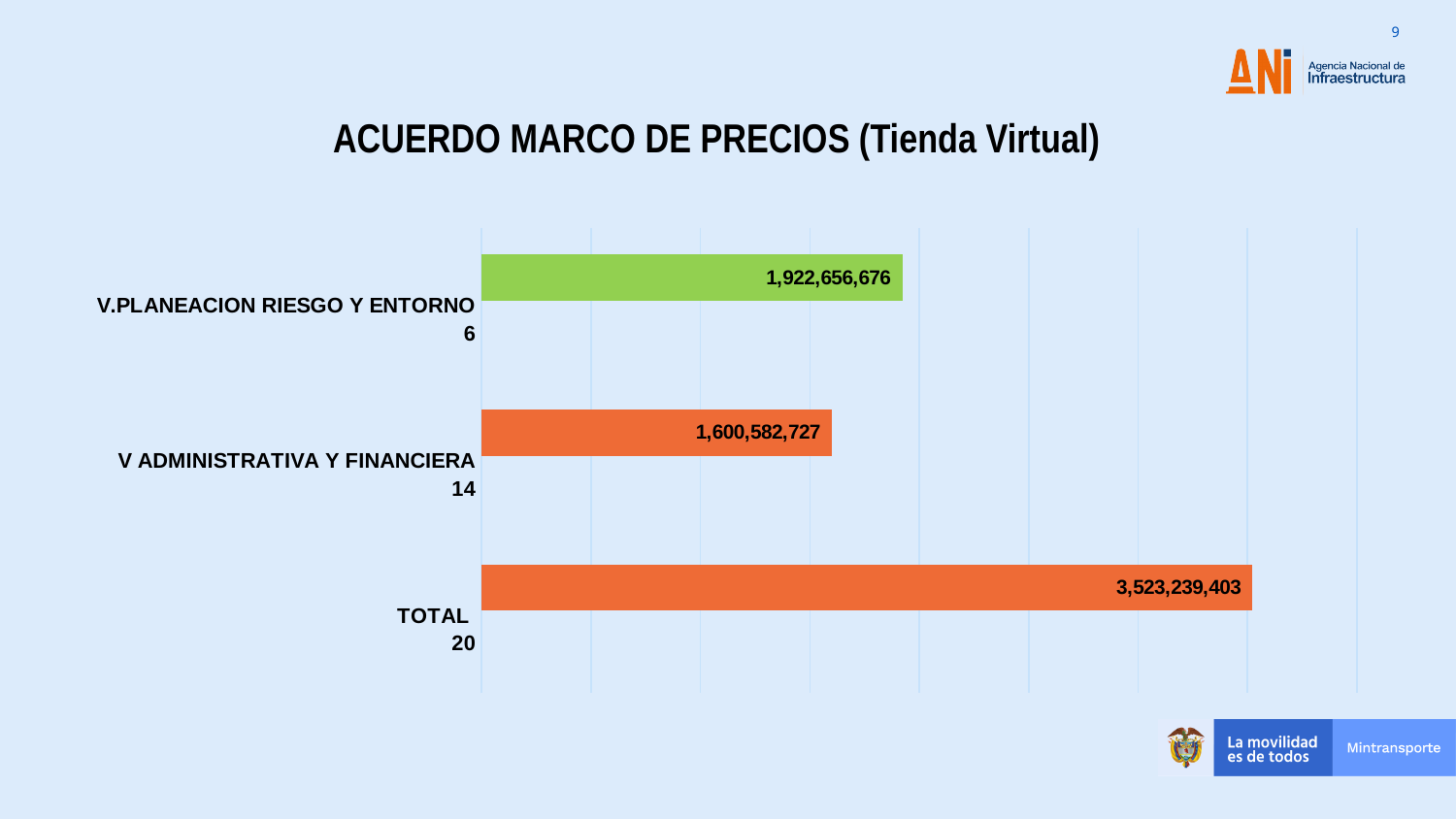
What is the value shown for V.PLANEACION RIESGO Y ENTORNO? 1,922,656,676 Which is larger, the value for V.PLANEACION RIESGO Y ENTORNO or the value for V ADMINISTRATIVA Y FINANCIERA? V.PLANEACION RIESGO Y ENTORNO What type of chart is shown on the slide? Bar chart What is the title of the slide? ACUERDO MARCO DE PRECIOS (Tienda Virtual) What is the value shown for the TOTAL bar? 3,523,239,403 Which category has the shortest bar? V ADMINISTRATIVA Y FINANCIERA What number is shown under the TOTAL label? 20 What is the difference between the values for V.PLANEACION RIESGO Y ENTORNO and V ADMINISTRATIVA Y FINANCIERA? 322,073,949 How many bars are shown in the chart? 3 Which category has the longest bar? TOTAL What is the value shown for V ADMINISTRATIVA Y FINANCIERA? 1,600,582,727 What number is shown under the label V ADMINISTRATIVA Y FINANCIERA? 14